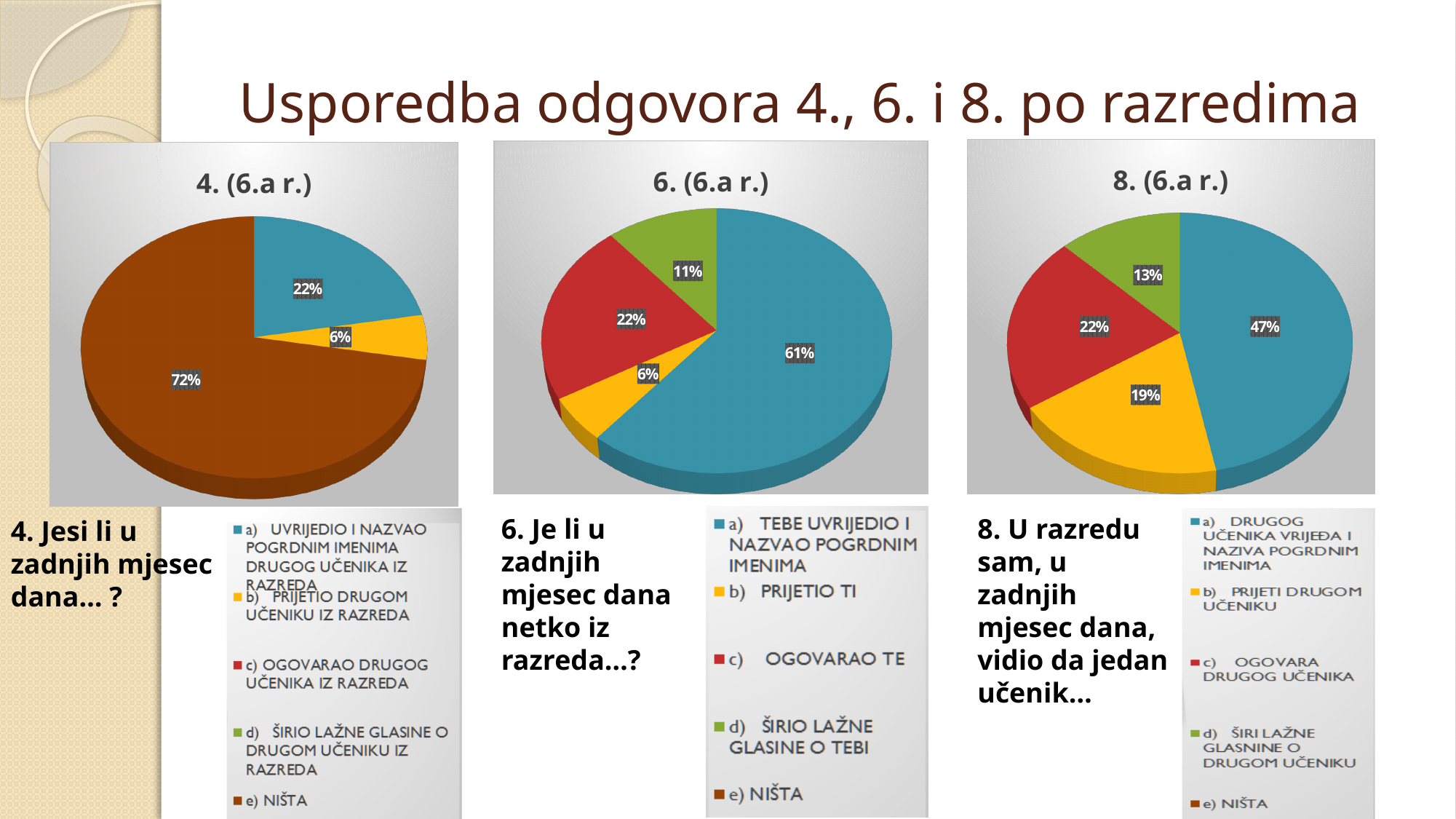
In the chart titled "6. (6.a r.)", what percentage is shown for the blue slice (a) TEBE UVRIJEDIO I NAZVAO POGRDNIM IMENIMA)? 61% In the chart titled "8. (6.a r.)", which slice has the largest share? a) DRUGOG UČENIKA VRIJEĐA I NAZIVA POGRDNIM IMENIMA (47%) In the chart titled "4. (6.a r.)", what is the difference between the brown slice (72%) and the blue slice (22%)? 50% In the chart titled "6. (6.a r.)", what percentage is shown for the green slice (d) ŠIRIO LAŽNE GLASINE O TEBI)? 11% What type of chart is used for the three charts on the slide? Pie chart How many entries does the legend of the chart titled "6. (6.a r.)" list? 5 In the chart titled "8. (6.a r.)", what percentage is shown for the yellow slice (b) PRIJETI DRUGOM UČENIKU)? 19% In the chart titled "4. (6.a r.)", what percentage is shown for the yellow slice (b) PRIJETIO DRUGOM UČENIKU IZ RAZREDA)? 6% In the chart titled "4. (6.a r.)", what percentage is shown for the brown slice (e) NIŠTA)? 72% In the chart titled "6. (6.a r.)", which slice has the smallest share? b) PRIJETIO TI (6%) In the chart titled "8. (6.a r.)", which is larger: the blue slice (a) or the red slice (c)? The blue slice (a), 47% In the chart titled "8. (6.a r.)", what percentage is shown for the red slice (c) OGOVARA DRUGOG UČENIKA)? 22%